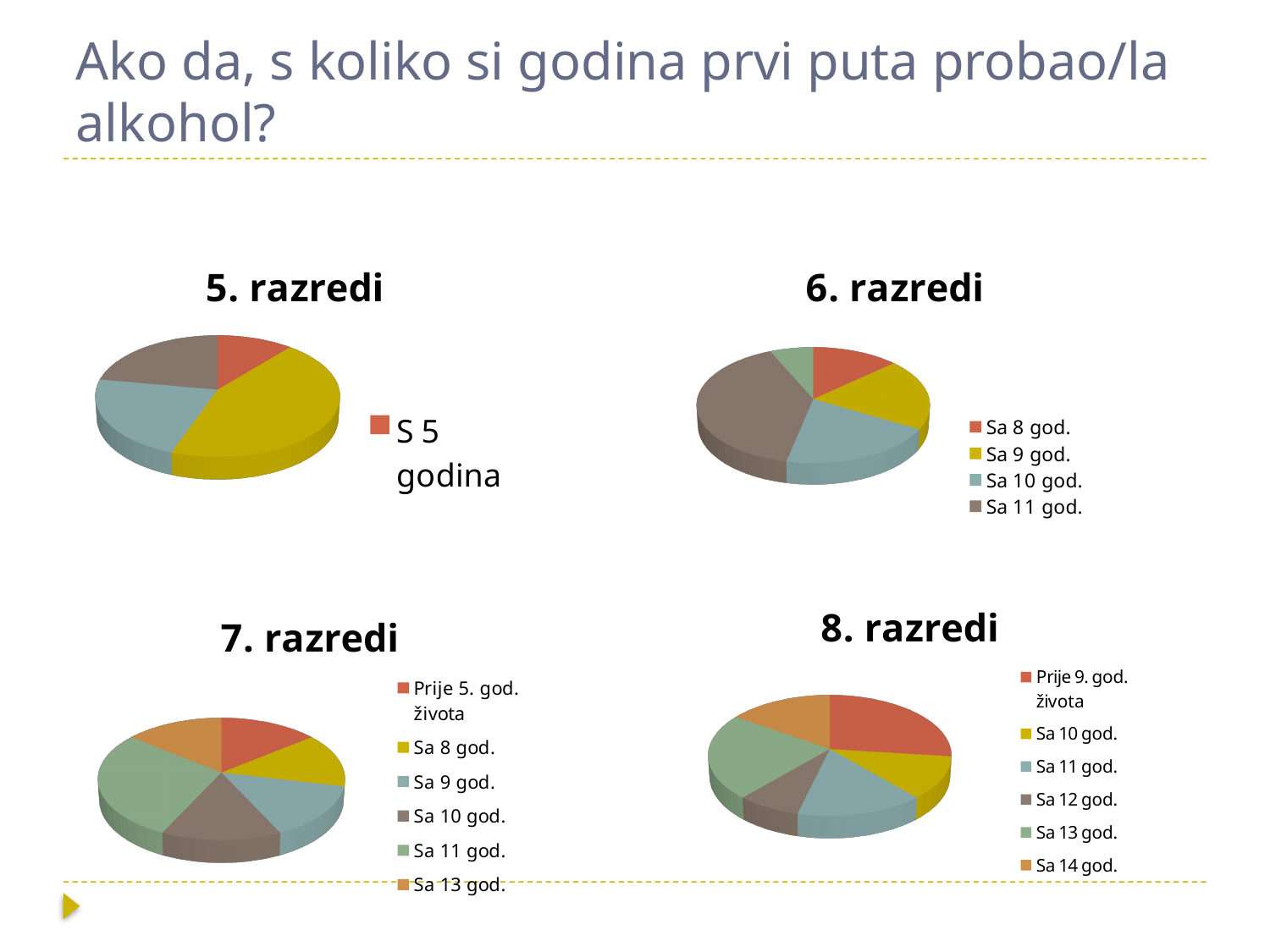
In the "6. razredi" chart, which legend category has the largest slice? Sa 11 god. How many categories does the legend of the "8. razredi" chart list? 6 In the "8. razredi" chart, which category has the smallest slice? Sa 12 god. In the "6. razredi" chart, which is larger: the slice for Sa 11 god. or the slice for Sa 8 god.? Sa 11 god. In the "7. razredi" chart, which is larger: the slice for Sa 11 god. or the slice for Sa 8 god.? Sa 11 god. How many charts are shown on the slide? 4 What kind of chart is the "6. razredi" chart? pie chart In the "8. razredi" chart, which is larger: the slice for Sa 11 god. or the slice for Sa 12 god.? Sa 11 god. What is the title of the chart in the top-left of the slide? 5. razredi How many categories does the legend of the "7. razredi" chart list? 6 In the "7. razredi" chart, which category has the largest slice? Sa 11 god.